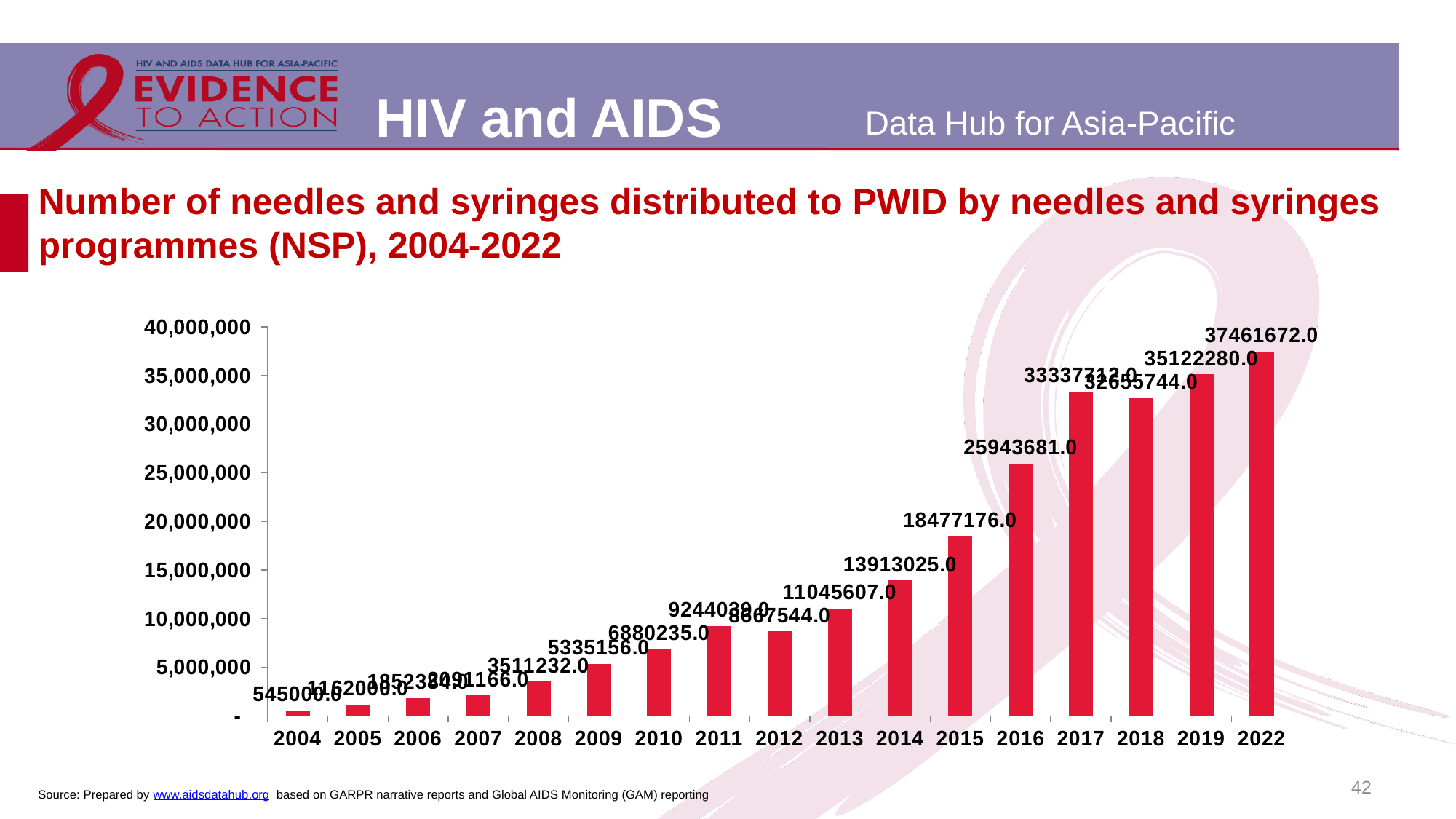
What type of chart is shown on the slide? Bar chart How many years (bars) are plotted in the chart? 17 Which year has the highest number of needles and syringes distributed? 2022 What is the number of needles and syringes distributed in 2014? 13913025.0 Which year has the lowest number of needles and syringes distributed? 2004 What is the number of needles and syringes distributed in 2009? 5335156.0 What is the number of needles and syringes distributed in 2022? 37461672.0 What is the number of needles and syringes distributed in 2016? 25943681.0 Is the value for 2017 greater or less than 30,000,000? greater Do the values generally rise or fall from 2004 to 2022? Rise Which year has a larger value, 2011 or 2012? 2011 What is the difference between the values for 2022 and 2019? 2339392.0